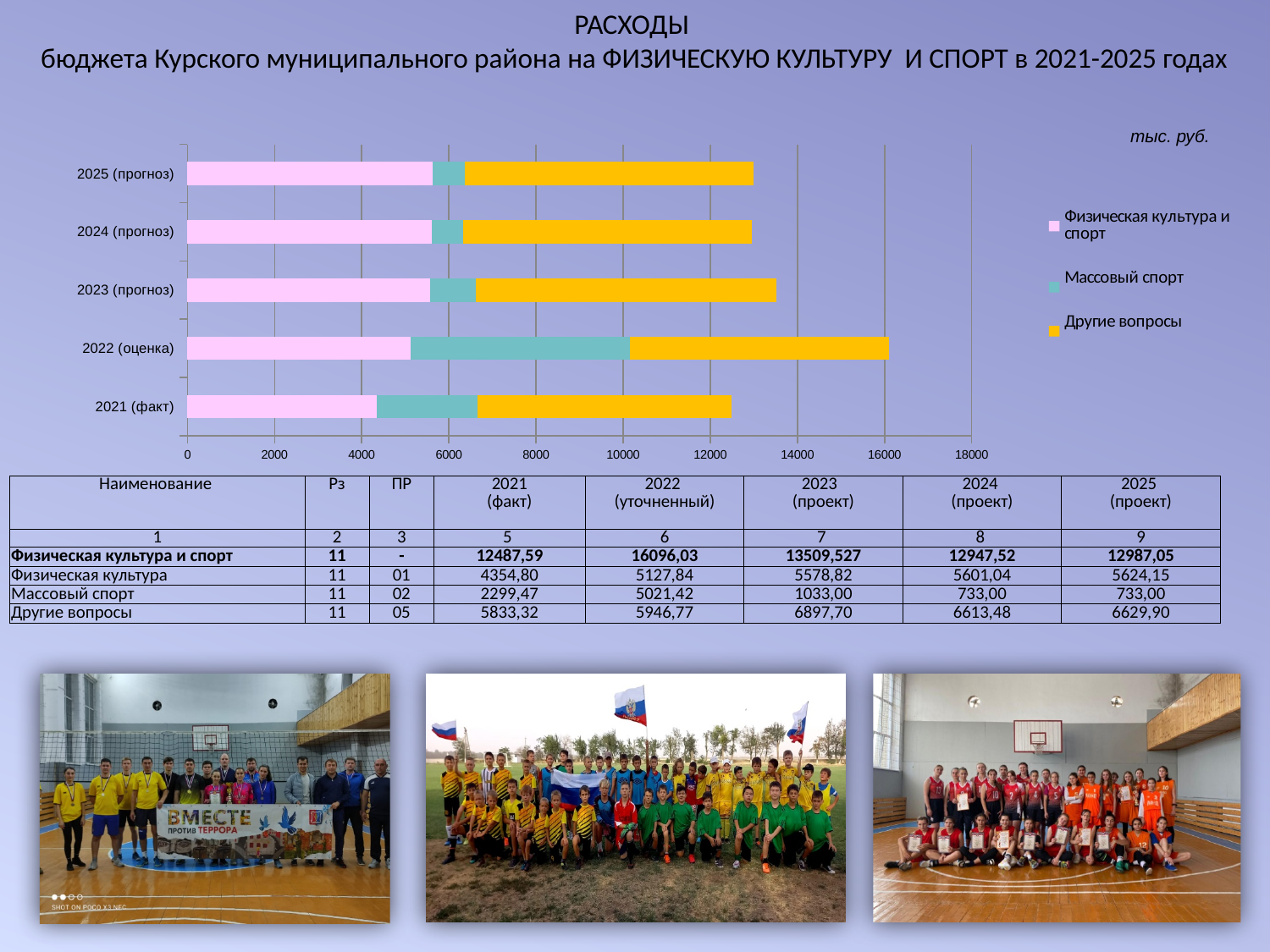
According to the table on the slide, what is the value for Массовый спорт in 2021 (факт)? 2299,47 What kind of chart is shown on the slide? bar chart According to the table on the slide, what is the total for Физическая культура и спорт in 2022? 16096,03 Is the total bar for 2021 (факт) greater or less than 14000? less How many year categories are plotted on the chart? 5 Does the total bar length rise or fall from 2022 (оценка) to 2023 (прогноз)? falls In what units are the chart values given, as noted above the legend? тыс. руб. Is the total bar for 2022 (оценка) greater or less than 14000? greater How many series does the chart legend list? 3 Using the table values, what is the difference between the Физическая культура и спорт totals for 2022 and 2021? 3608,44 Which year has the longest total bar on the chart? 2022 (оценка) Is the Массовый спорт segment larger in 2022 (оценка) or in 2023 (прогноз)? 2022 (оценка)